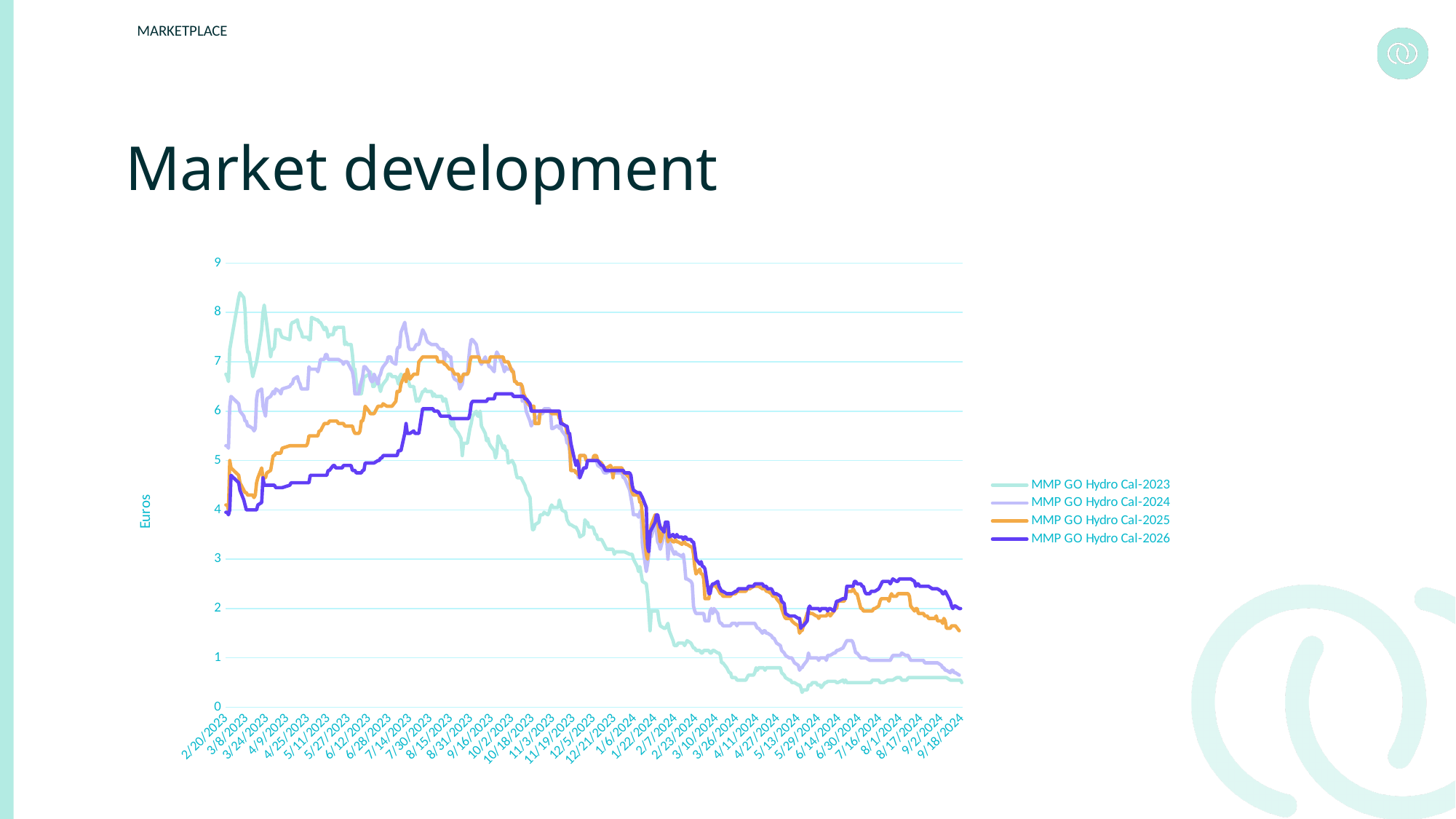
At 9/18/2024, which is higher: MMP GO Hydro Cal-2026 or MMP GO Hydro Cal-2023? MMP GO Hydro Cal-2026 Is the value for MMP GO Hydro Cal-2023 at 9/18/2024 greater or less than 1? less Is the value for MMP GO Hydro Cal-2026 at 2/20/2023 greater or less than 5? less Is the value for MMP GO Hydro Cal-2025 at 9/18/2024 greater or less than 2? less What is the title of the vertical axis? Euros At 2/20/2023, which is higher: MMP GO Hydro Cal-2023 or MMP GO Hydro Cal-2026? MMP GO Hydro Cal-2023 What kind of chart is shown on the slide? line chart Which series reaches the highest value anywhere on the chart? MMP GO Hydro Cal-2023 What are the series names listed in the legend? MMP GO Hydro Cal-2023, MMP GO Hydro Cal-2024, MMP GO Hydro Cal-2025, MMP GO Hydro Cal-2026 Does the MMP GO Hydro Cal-2023 series rise or fall overall from 2/20/2023 to 9/18/2024? fall How many series does the legend list? 4